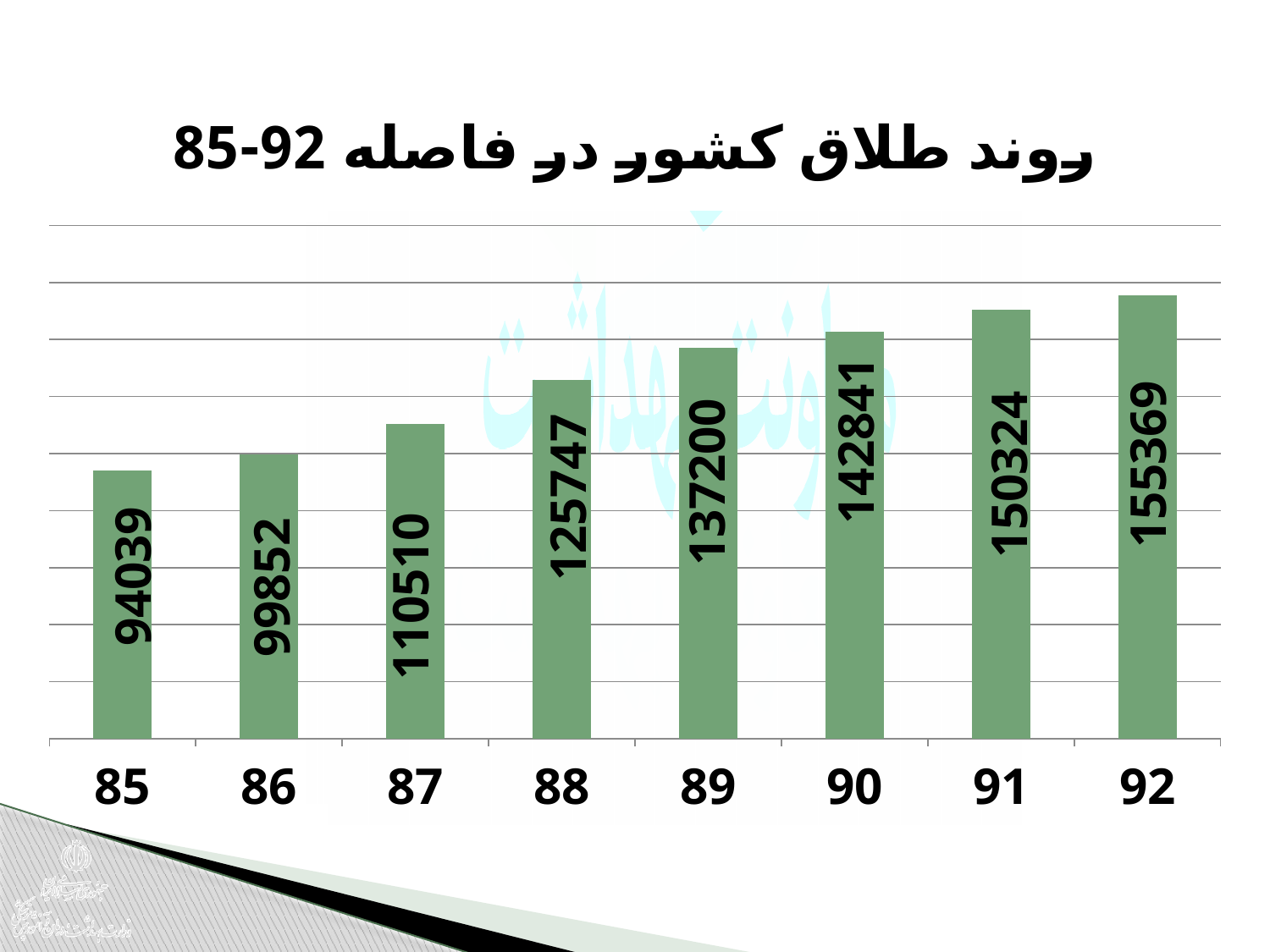
Which category has the lowest value? 85 What is the difference between the values for 92 and 85? 61330 What is the title of the chart? روند طلاق کشور در فاصله 85-92 What is the difference between the values for 87 and 86? 10658 Which category has the highest value? 92 Which is larger, the value for 89 or the value for 90? 90 Do the values rise or fall from 85 to 92? rise What kind of chart is this? bar chart What is the value for 88? 125747 What is the value for 85? 94039 What is the value for 92? 155369 How many categories are shown on the x axis? 8